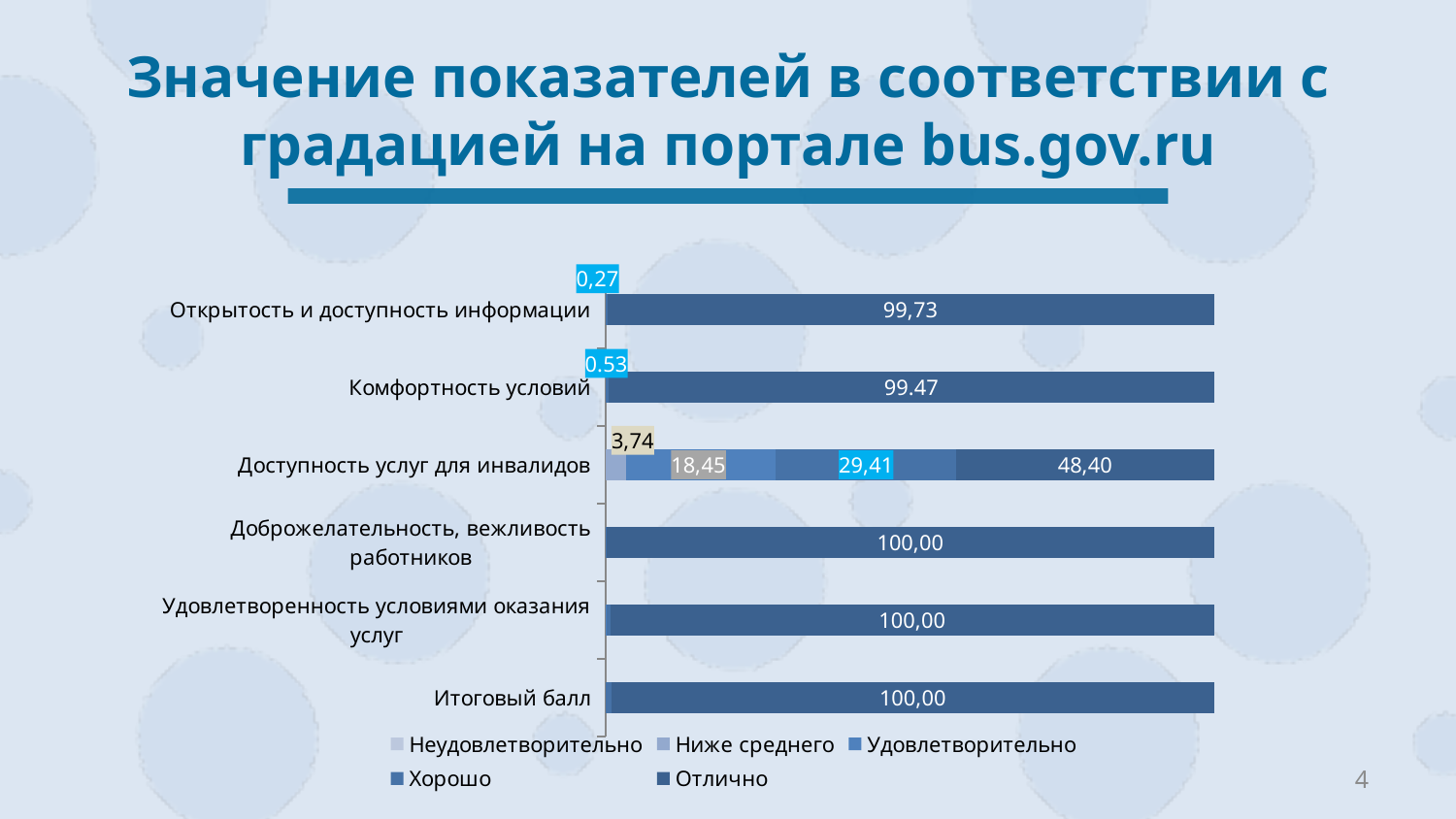
What kind of chart is shown on the slide? Stacked horizontal bar chart What is the first entry in the chart legend? Неудовлетворительно How many categories are plotted on the chart? 6 Which category's bar is split into the most segments? Доступность услуг для инвалидов What is the smallest segment value in the bar for 'Доступность услуг для инвалидов'? 3,74 How many series does the legend list? 5 What is the value of the large segment for 'Комфортность условий'? 99.47 What is the total of the stacked bar for 'Доступность услуг для инвалидов'? 100,00 What value is shown for 'Итоговый балл'? 100,00 In the bar for 'Доступность услуг для инвалидов', what is the difference between the 48,40 segment and the 29,41 segment? 18,99 What value is shown for 'Доброжелательность, вежливость работников'? 100,00 What is the value of the large segment for 'Открытость и доступность информации'? 99,73